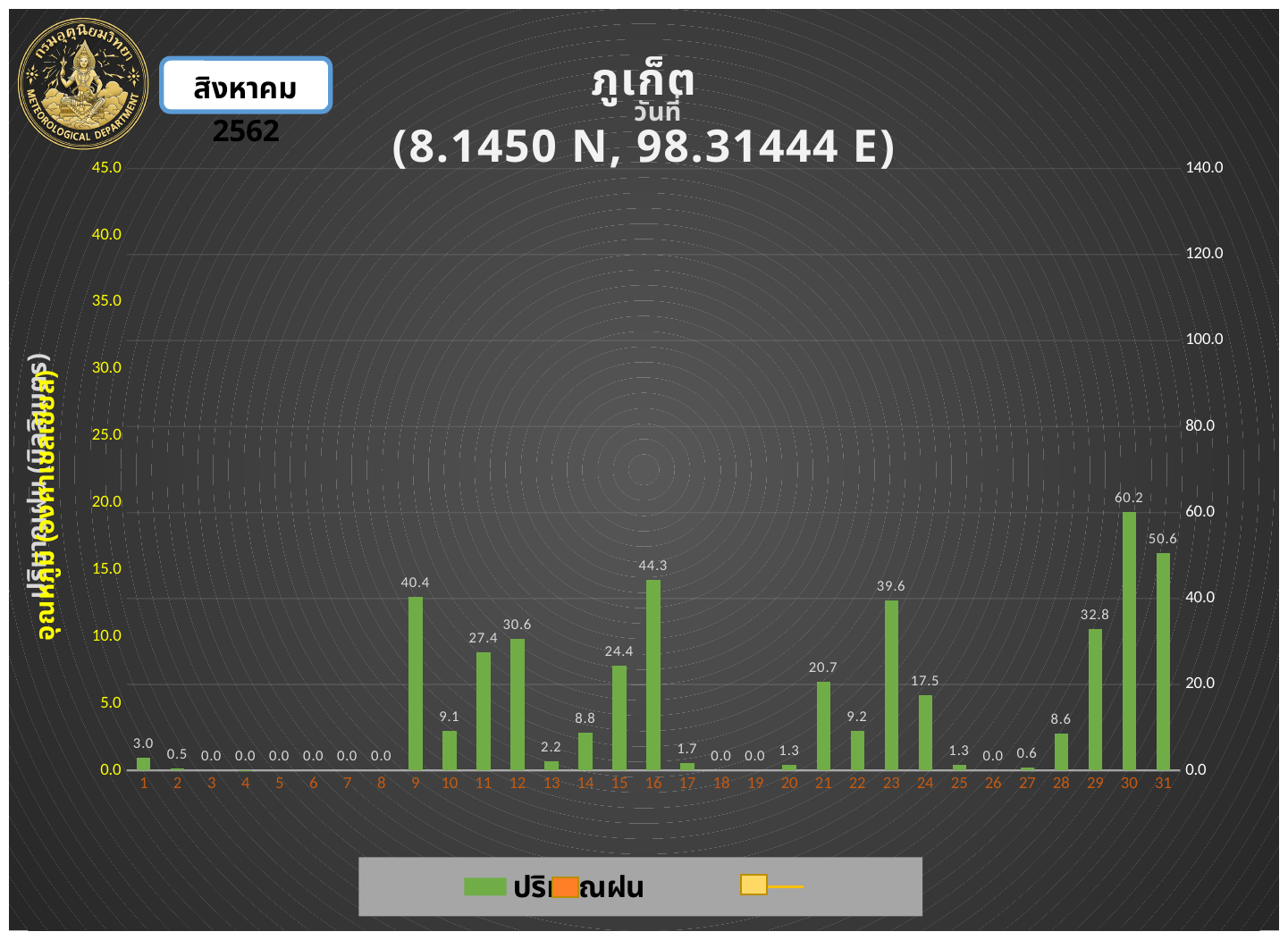
Which is larger, the rainfall value for day 29 or for day 15? day 29 What is the rainfall value shown for day 9? 40.4 Which is larger, the rainfall value for day 21 or for day 24? day 21 Which day has the highest rainfall value? 30 What is the difference between the rainfall values for day 12 and day 11? 3.2 What is the rainfall value shown for day 16? 44.3 What kind of chart is shown on the slide? bar chart What is the rainfall value shown for day 30? 60.2 How many days are shown on the x axis of the chart? 31 What is the rainfall value shown for day 23? 39.6 What is the place name in the chart title? ภูเก็ต What is the difference between the rainfall values for day 30 and day 31? 9.6